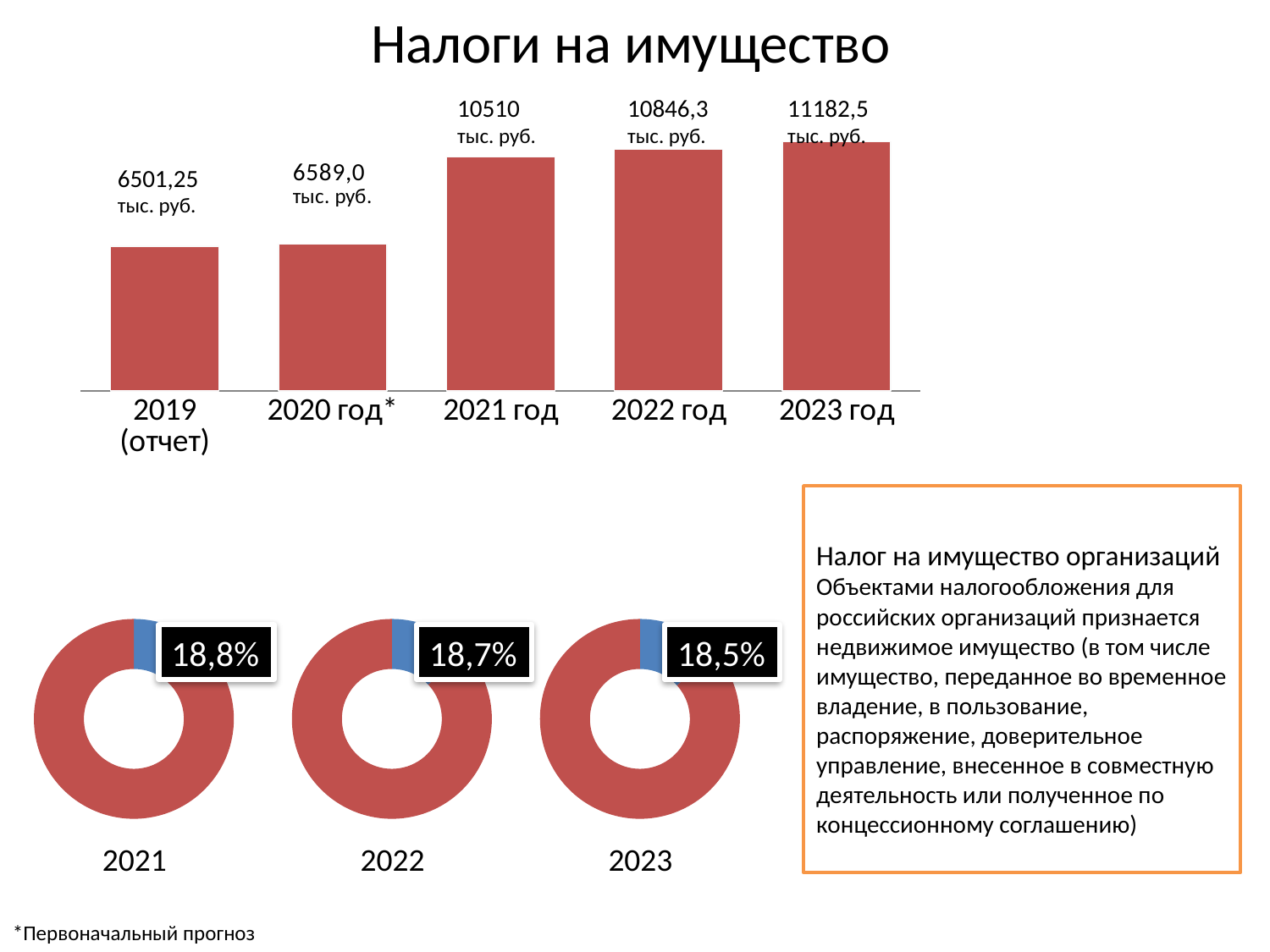
In the bar chart 'Налоги на имущество', do the values rise or fall from 2019 to 2023? rise In the bar chart 'Налоги на имущество', what is the value for 2019 (отчет)? 6501,25 тыс. руб. In the bar chart 'Налоги на имущество', which is larger: the value for 2020 год* or the value for 2022 год? 2022 год In the bar chart 'Налоги на имущество', which year has the lowest value? 2019 (отчет) What type of chart is the chart at the top of the slide titled 'Налоги на имущество'? bar chart In the bar chart 'Налоги на имущество', what is the value for 2021 год? 10510 тыс. руб. How many bars are in the bar chart 'Налоги на имущество'? 5 In the bar chart 'Налоги на имущество', what is the difference between the values for 2023 год and 2022 год? 336,2 тыс. руб. In the bar chart 'Налоги на имущество', which year has the highest value? 2023 год In the bar chart 'Налоги на имущество', what is the difference between the values for 2021 год and 2020 год*? 3921,0 тыс. руб. In the donut chart labelled 2022 at the bottom of the slide, what share does the blue slice represent? 18,7% In the bar chart 'Налоги на имущество', what is the value for 2023 год? 11182,5 тыс. руб.